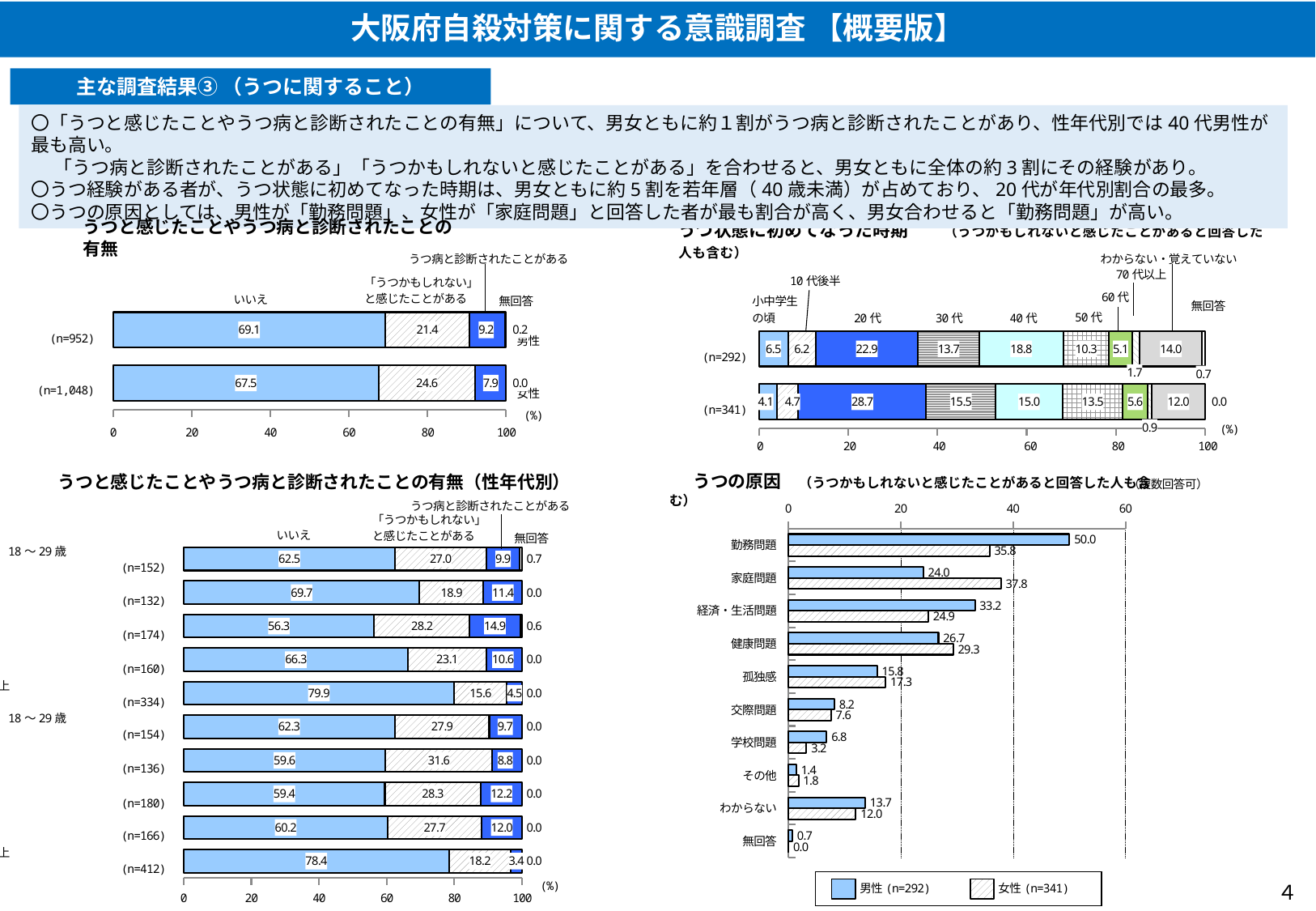
In the bottom-left chart (うつと感じたことやうつ病と診断されたことの有無（性年代別）), what is the 「いいえ」 value for the n=334 bar? 79.9 In the top-left chart (うつと感じたことやうつ病と診断されたことの有無), what is the value of 「うつ病と診断されたことがある」 for 男性 (n=952)? 9.2 In the top-left chart (うつと感じたことやうつ病と診断されたことの有無), what is the value of 「いいえ」 for 女性 (n=1,048)? 67.5 In the top-right chart (うつ状態に初めてなった時期), what is the value of わからない・覚えていない for the n=292 bar? 14.0 In the bottom-right chart (うつの原因), what is the value of 勤務問題 for 男性 (n=292)? 50.0 In the bottom-left chart (うつと感じたことやうつ病と診断されたことの有無（性年代別）), which bar has the highest 「うつ病と診断されたことがある」 value? n=174 In the top-left chart (うつと感じたことやうつ病と診断されたことの有無), what is the difference between the 「うつかもしれない」と感じたことがある values for 女性 and 男性? 3.2 In the bottom-right chart (うつの原因), how many series does the legend list? 2 In the bottom-right chart (うつの原因), which category has the highest value for 女性 (n=341)? 家庭問題 In the top-right chart (うつ状態に初めてなった時期), what is the value of 20代 for the n=341 bar? 28.7 In the top-right chart (うつ状態に初めてなった時期), which segment has the highest value in the n=292 bar? 20代 In the bottom-left chart (うつと感じたことやうつ病と診断されたことの有無（性年代別）), how many bars are shown? 10